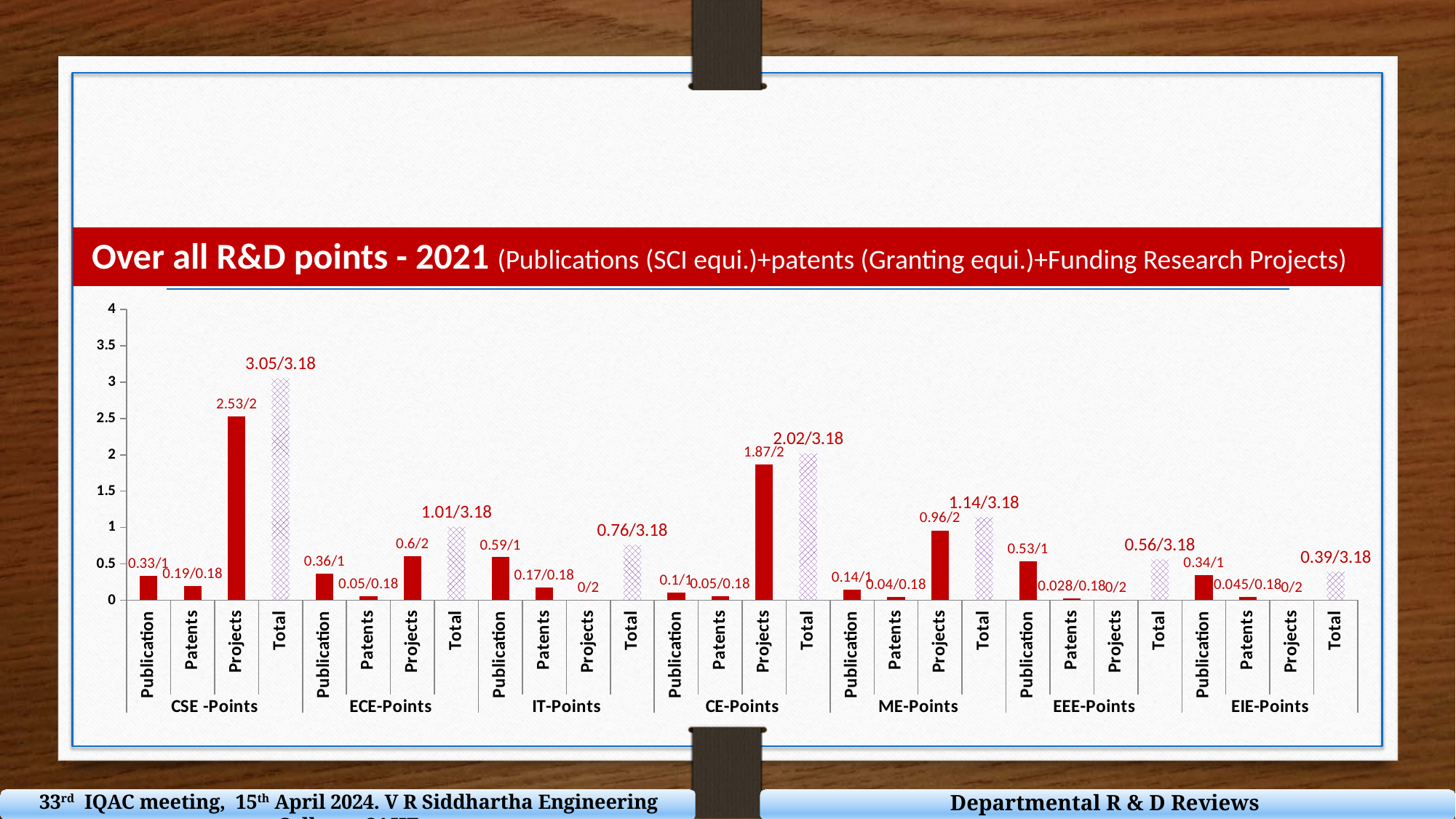
Which is larger, the Projects bar for CSE-Points or the Projects bar for CE-Points? CSE-Points How many departments are shown along the x axis? 7 What is the data label shown for the Patents bar of EEE-Points? 0.028/0.18 Which department has the highest Total bar? CSE-Points What is the data label shown for the Publication bar of IT-Points? 0.59/1 How many departments have a Projects bar labelled 0/2? 3 What is the data label shown for the Projects bar of CE-Points? 1.87/2 Which department has the lowest Total bar? EIE-Points What is the data label shown for the Total bar of CSE-Points? 3.05/3.18 What kind of chart is shown on the slide? Bar chart Is the Total bar for ME-Points greater or less than 1? greater What is the title of the chart? Over all R&D points - 2021